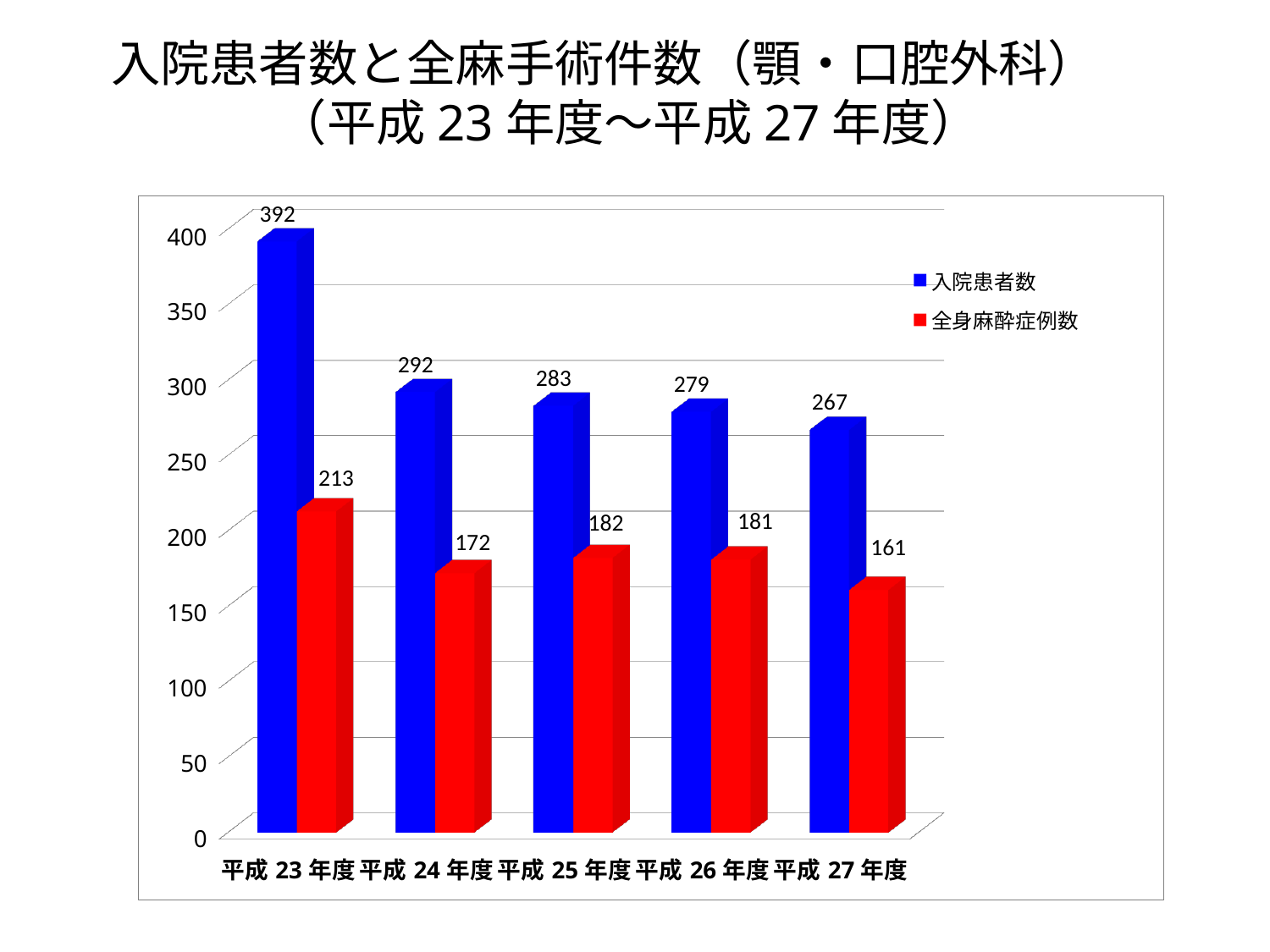
What is the value of 入院患者数 for 平成23年度? 392 Which is larger, 全身麻酔症例数 in 平成25年度 or in 平成27年度? 平成25年度 What is the value of 全身麻酔症例数 for 平成27年度? 161 How many series does the legend list? 2 What is the difference between 入院患者数 and 全身麻酔症例数 in 平成23年度? 179 Does 入院患者数 rise or fall from 平成23年度 to 平成27年度? fall How many years are shown on the x axis? 5 What is the difference in 入院患者数 between 平成24年度 and 平成27年度? 25 Which year has the highest 入院患者数? 平成23年度 What kind of chart is shown on the slide? bar chart Which year has the lowest 全身麻酔症例数? 平成27年度 What is the value of 全身麻酔症例数 for 平成24年度? 172